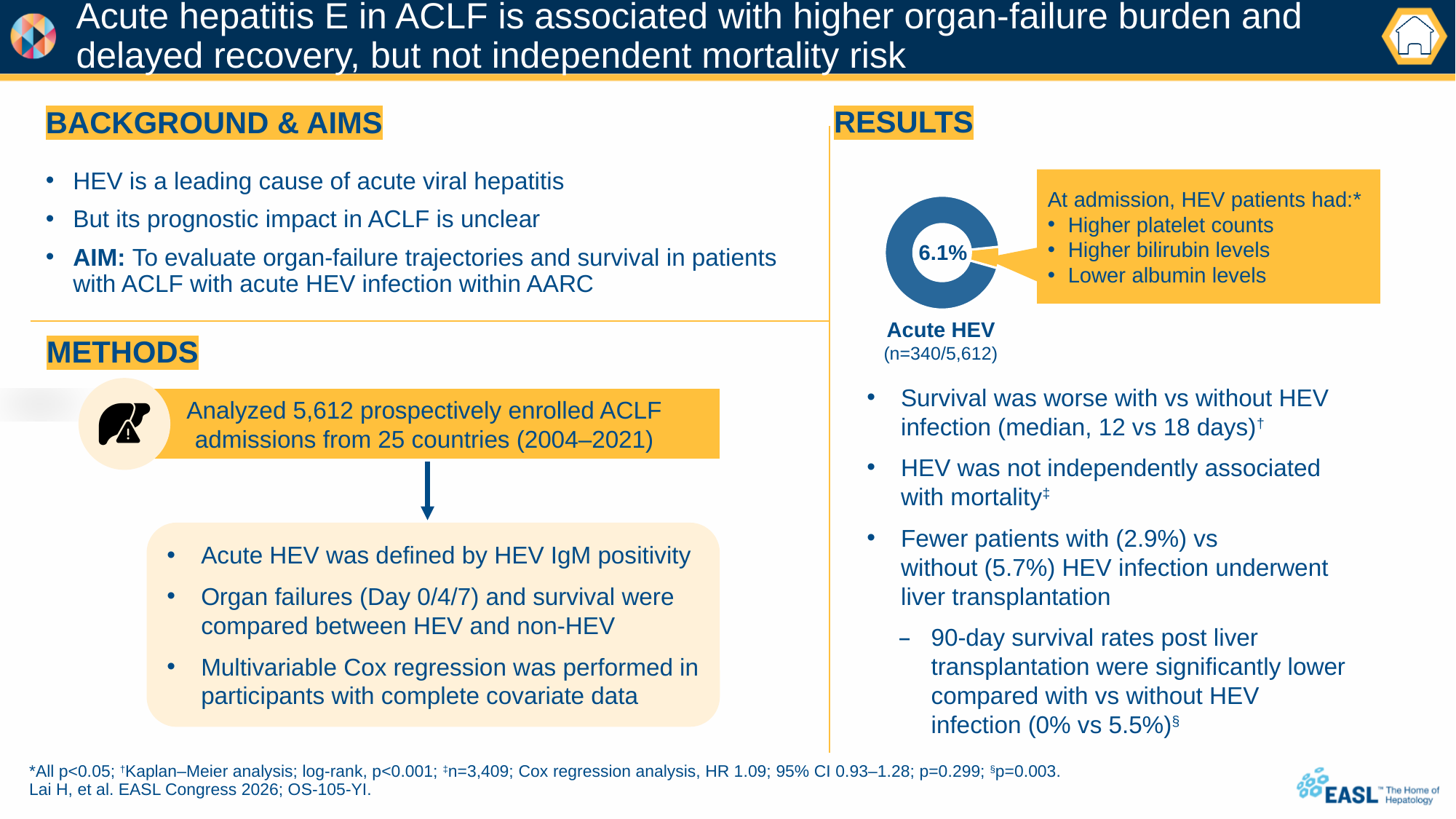
What share of the donut chart does the highlighted Acute HEV segment represent? 6.1% What percentage is printed in the centre of the donut chart? 6.1% What sample size (n) is printed beneath the donut chart? n=340/5,612 How many charts are shown on the slide? 1 What kind of chart is shown in the Results section? Pie (donut) chart Is the Acute HEV segment of the donut chart larger or smaller than the remaining segment? smaller What category label appears beneath the donut chart? Acute HEV